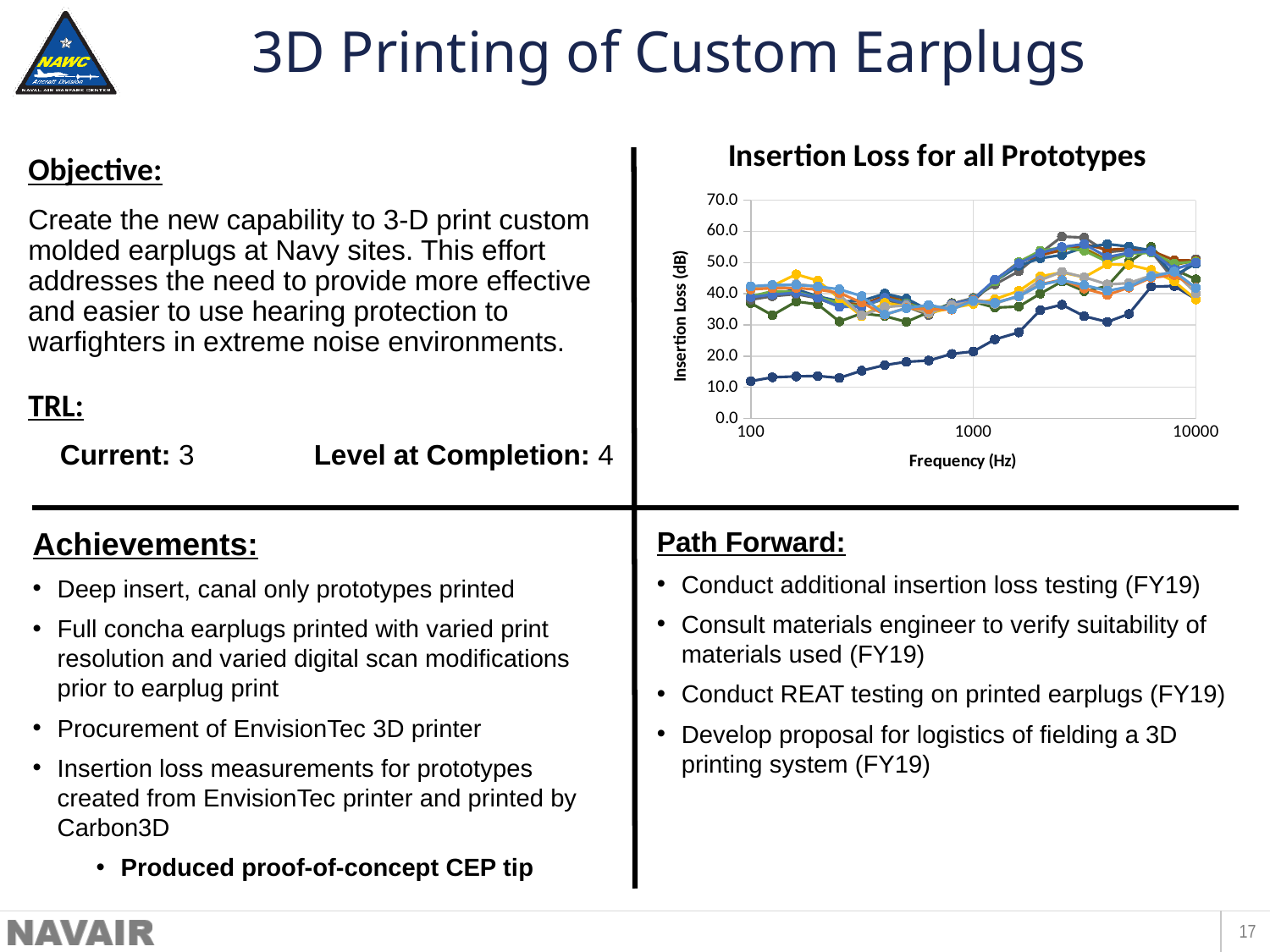
What is the label of the y axis of the chart? Insertion Loss (dB) Is the peak value of the highest line, near 3000 Hz, greater or less than 50.0? greater What is the title of the chart? Insertion Loss for all Prototypes What kind of chart is shown on the slide? Line chart Is the value of the lowest line at 10000 Hz greater or less than 40.0? less Is the highest value plotted at 100 Hz greater or less than 50.0? less Overall, do the plotted insertion loss values rise or fall from 1000 Hz to 3000 Hz? rise Does the lowest line rise or fall as frequency increases from 100 Hz to 10000 Hz? rise